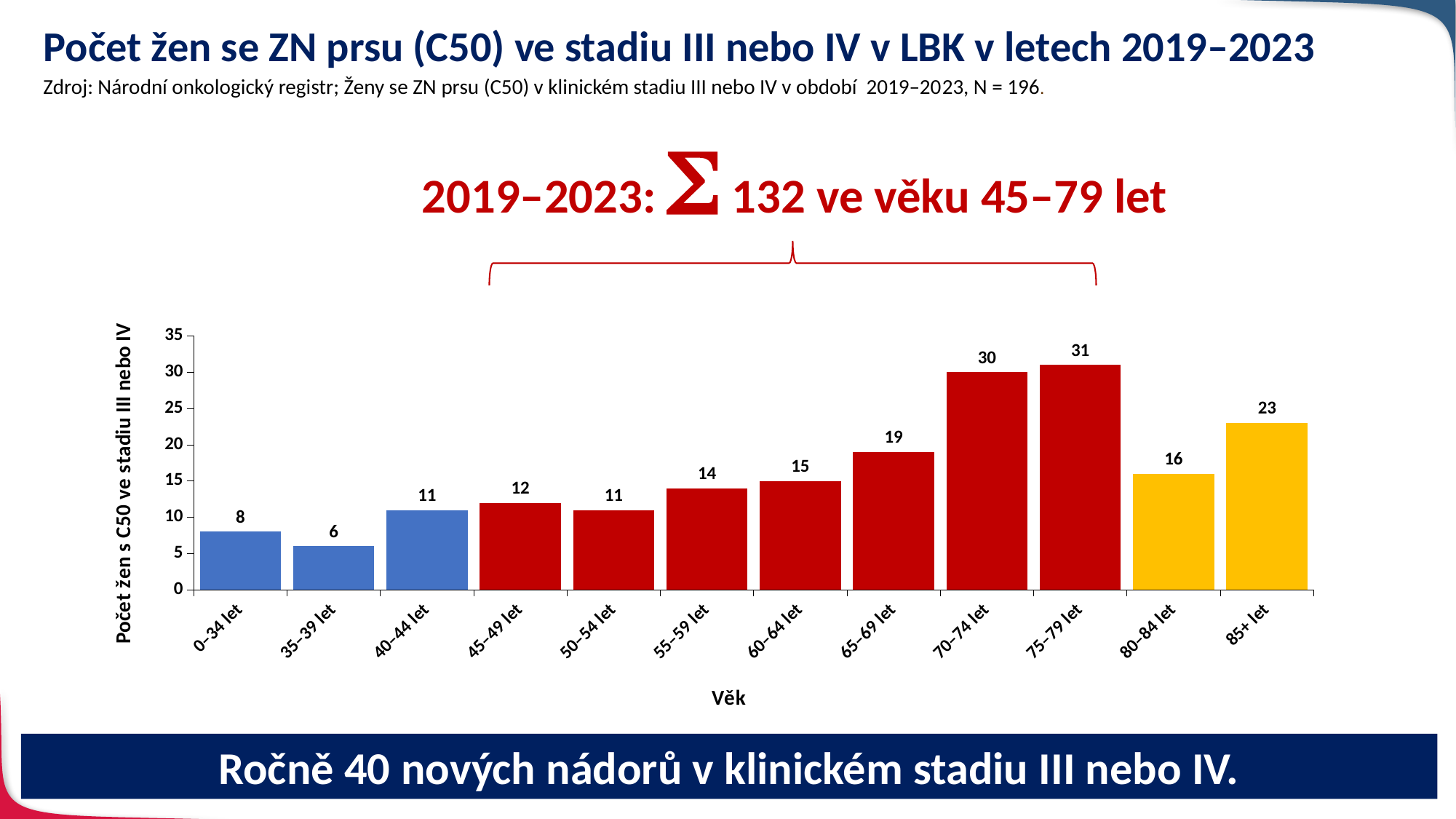
Which is larger, the value for 55–59 let or the value for 50–54 let? 55–59 let What kind of chart is shown on the slide? bar chart How many age groups are shown on the x axis? 12 What is the difference between the values for 75–79 let and 80–84 let? 15 Do the values rise or fall from 45–49 let to 75–79 let? rise What is the label of the x axis? Věk What is the value for the 85+ let age group? 23 Which age group has the lowest value? 35–39 let Which age group has the highest value? 75–79 let What is the value for the 35–39 let age group? 6 What is the value for the 70–74 let age group? 30 Is the value for 65–69 let greater or less than 15? greater